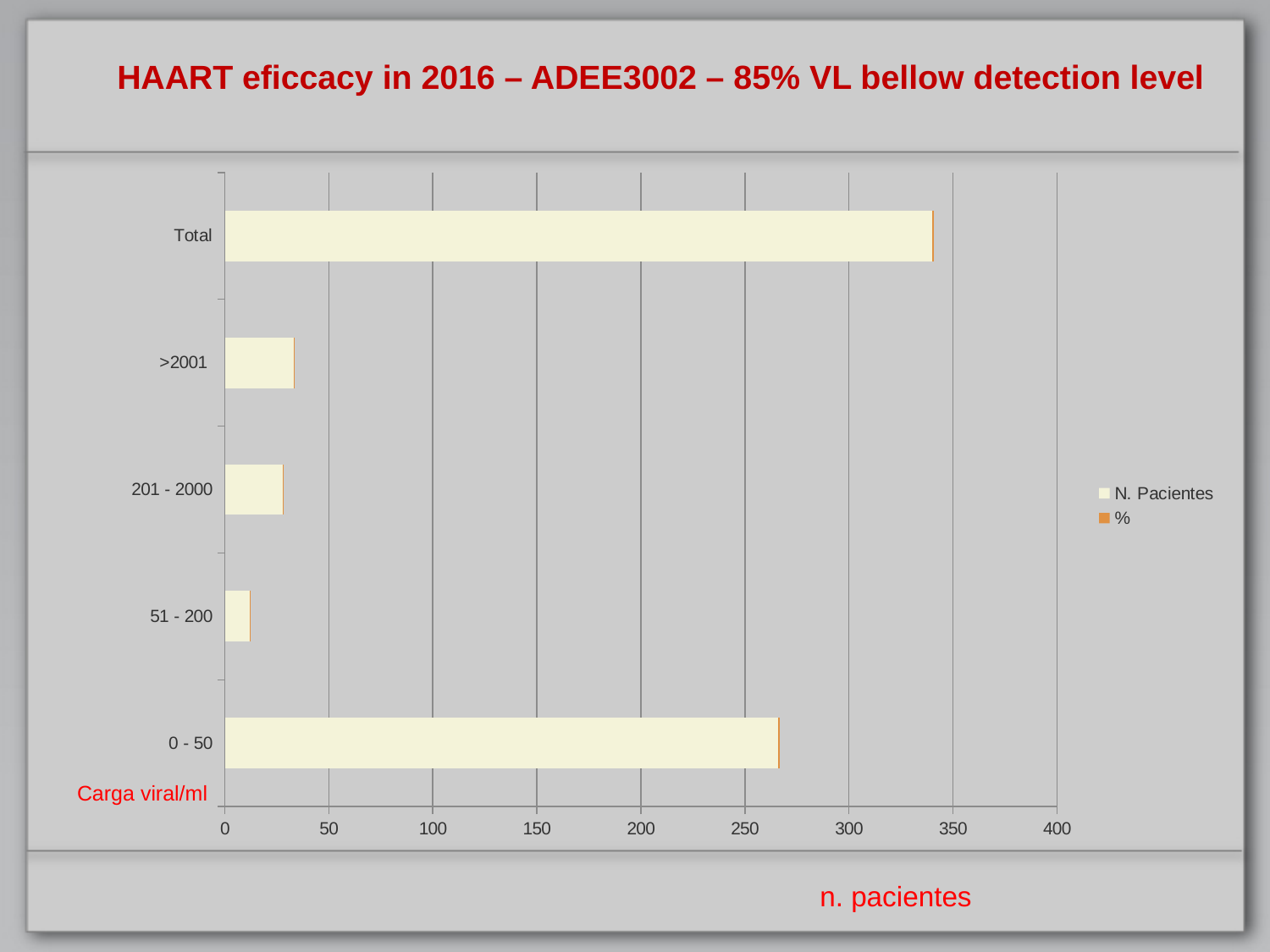
What are the two series names listed in the legend? N. Pacientes and % Is the N. Pacientes value for Total greater or less than 300? greater What kind of chart is shown on the slide? bar chart Is the N. Pacientes value for >2001 greater or less than 50? less Is the N. Pacientes value for 0 - 50 greater or less than 250? greater Which category has the lowest N. Pacientes value? 51 - 200 How many series does the legend list? 2 Which has a larger N. Pacientes value, 0 - 50 or >2001? 0 - 50 What is the title of the slide containing the chart? HAART eficcacy in 2016 – ADEE3002 – 85% VL bellow detection level How many categories are shown on the vertical axis of the chart? 5 Which category has the highest N. Pacientes value? Total